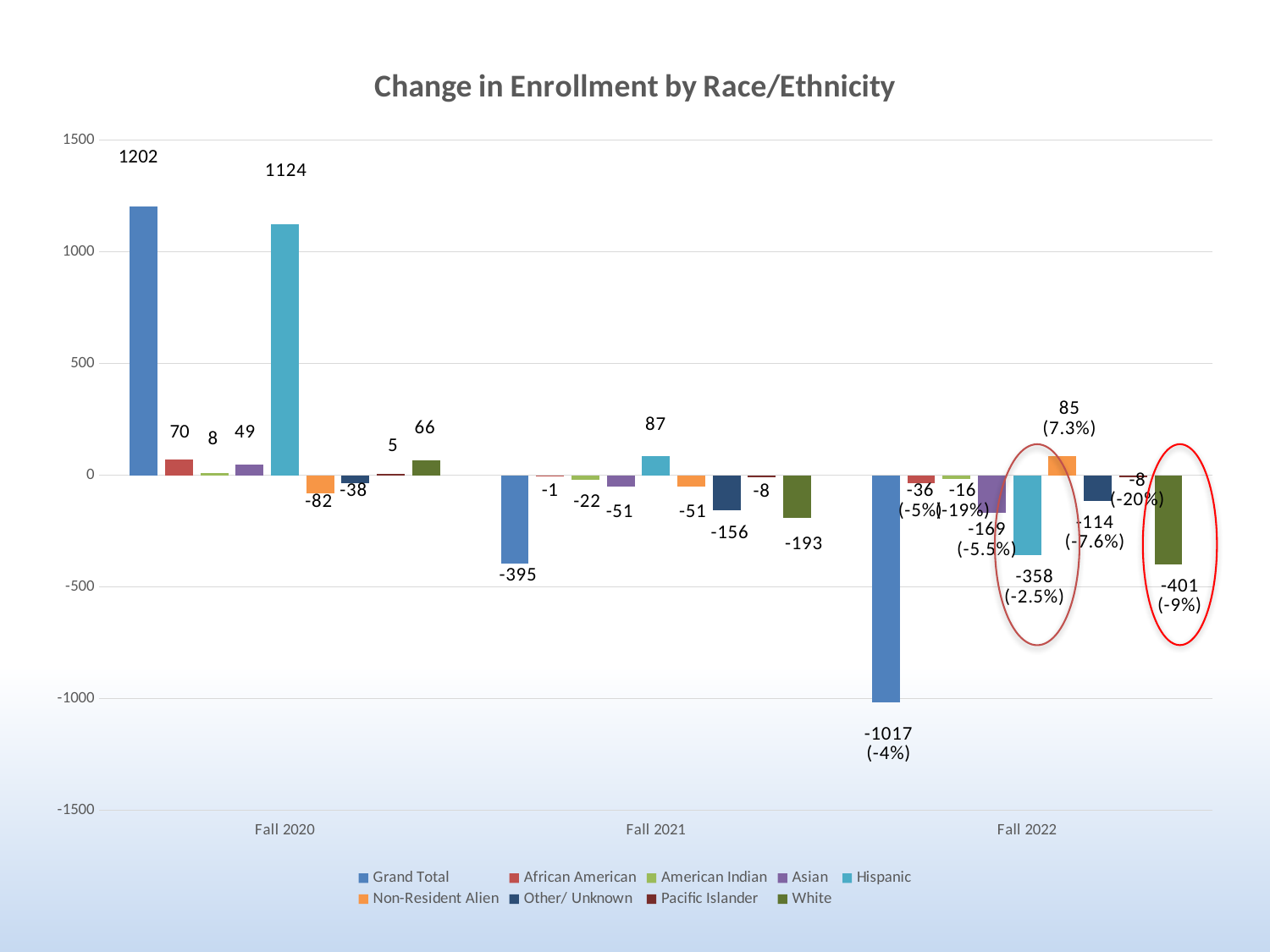
Does the Grand Total value rise or fall from Fall 2020 to Fall 2022? Fall How many categories (terms) are shown on the x axis? 3 Which term has the lowest Grand Total value? Fall 2022 What is the Hispanic value for Fall 2022? -358 What is the Grand Total value for Fall 2020? 1202 What is the title of the chart? Change in Enrollment by Race/Ethnicity Which is larger in Fall 2021: the Hispanic value or the Asian value? Hispanic What is the White value for Fall 2021? -193 What percentage change is shown for Non-Resident Alien in Fall 2022? 7.3% What is the difference between the Grand Total for Fall 2020 and the Hispanic value for Fall 2020? 78 How many series does the legend list? 9 What type of chart is shown on the slide? Bar chart